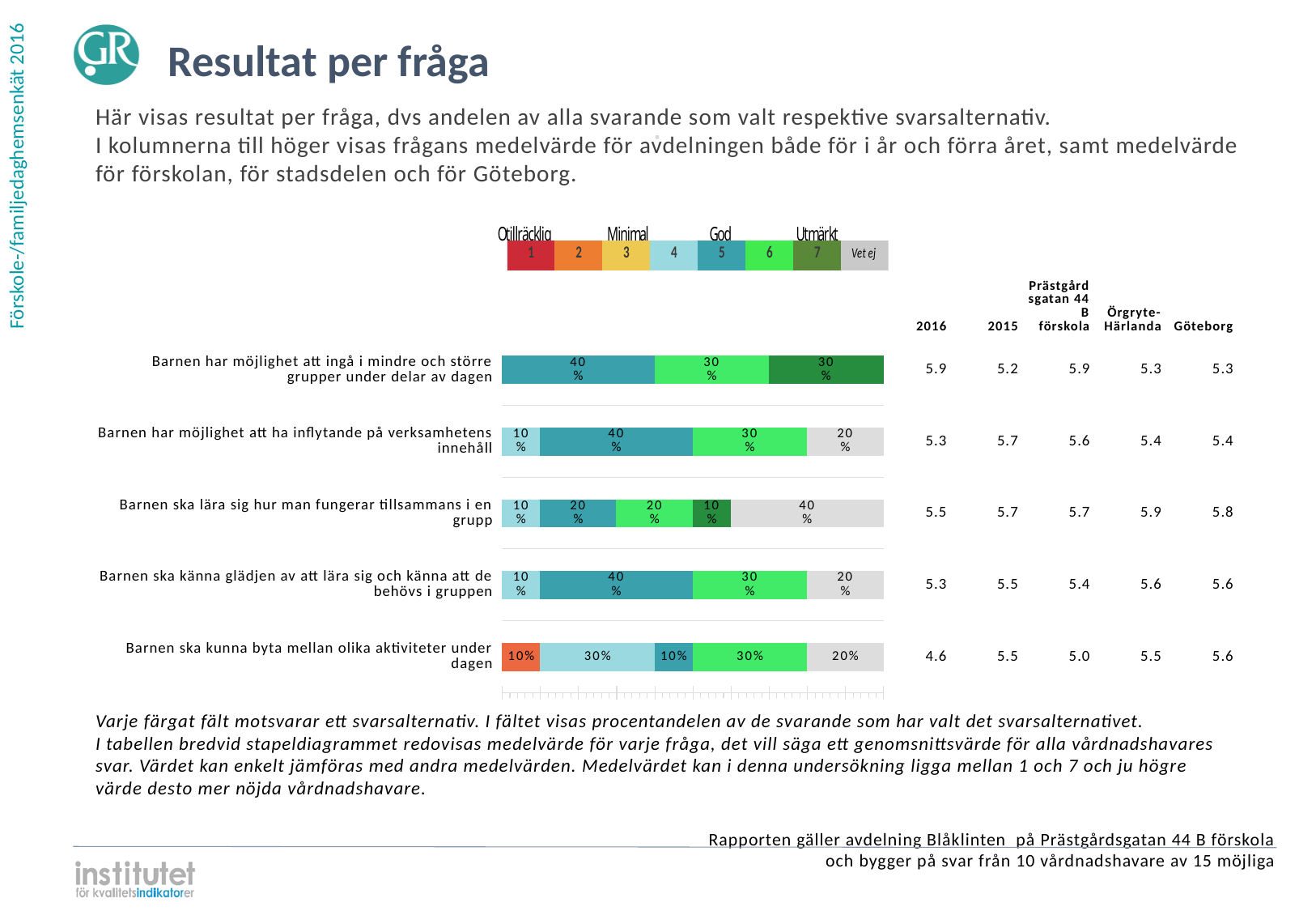
What is the 2016 mean value shown for 'Barnen ska kunna byta mellan olika aktiviteter under dagen'? 4.6 What percentage of respondents chose option 7 (Utmärkt) for 'Barnen har möjlighet att ingå i mindre och större grupper under delar av dagen'? 30% What percentage chose option 2 for 'Barnen ska kunna byta mellan olika aktiviteter under dagen'? 10% How many response categories does the legend above the chart list? 8 For 'Barnen ska kunna byta mellan olika aktiviteter under dagen', which is larger: the share for option 4 or the share for option 5? Option 4 What kind of chart is used to show the results per question? Stacked bar chart Which question has the largest 'Vet ej' share? Barnen ska lära sig hur man fungerar tillsammans i en grupp What label does the legend give to response options 1 and 2? Otillräcklig What is the difference between the option 5 share and the option 7 share for 'Barnen har möjlighet att ingå i mindre och större grupper under delar av dagen'? 10% What percentage chose option 5 (God) for 'Barnen har möjlighet att ha inflytande på verksamhetens innehåll'? 40% How many questions (bars) are shown in the chart? 5 What percentage chose 'Vet ej' for 'Barnen ska lära sig hur man fungerar tillsammans i en grupp'? 40%